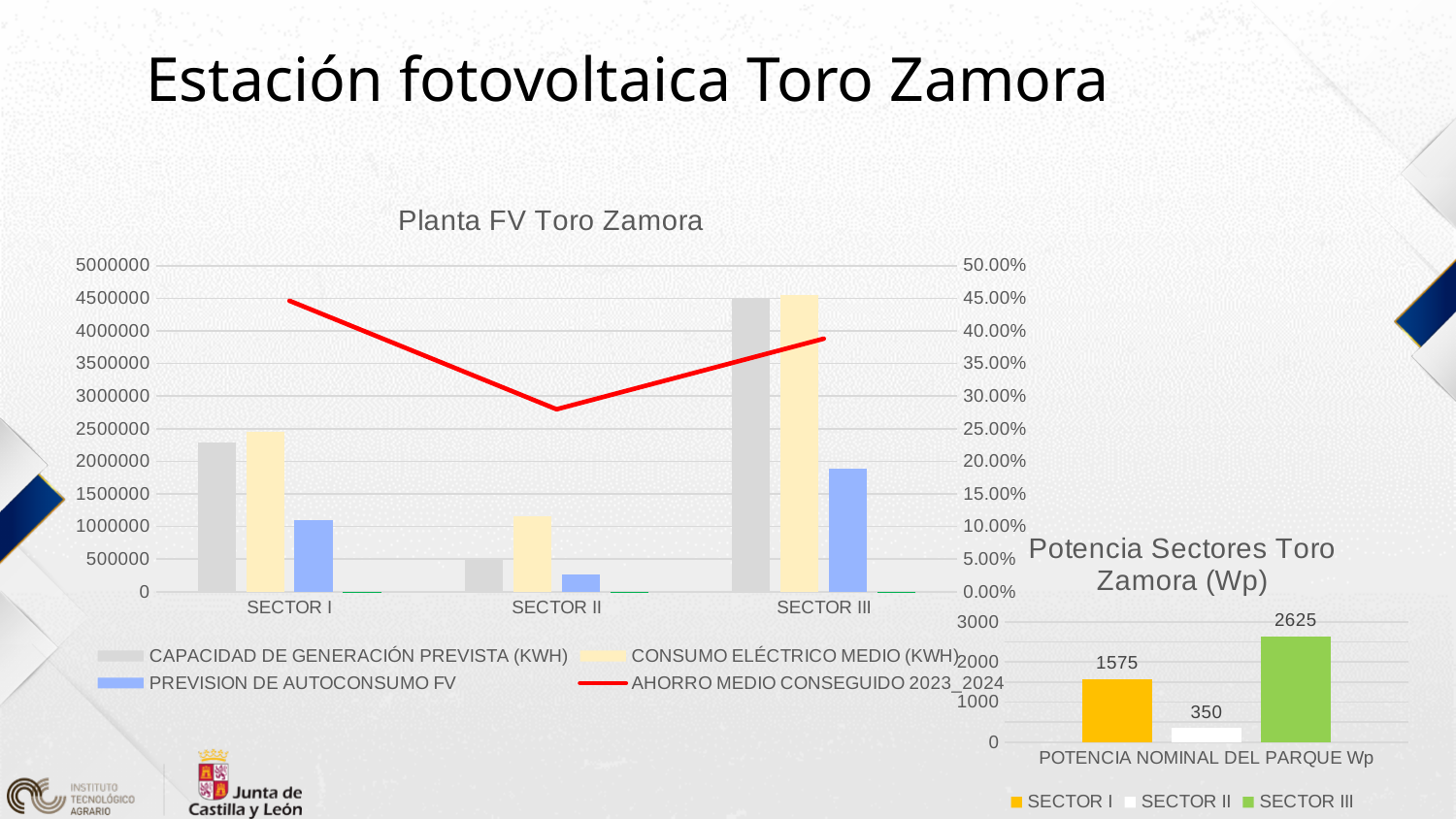
In the 'Potencia Sectores Toro Zamora (Wp)' chart, which sector has the highest value? SECTOR III In the 'Potencia Sectores Toro Zamora (Wp)' chart, which sector has the lowest value? SECTOR II In the 'Potencia Sectores Toro Zamora (Wp)' chart, what is the value for SECTOR I? 1575 In the 'Potencia Sectores Toro Zamora (Wp)' chart, what is the difference between SECTOR III and SECTOR I? 1050 In the 'Planta FV Toro Zamora' chart, how many sector categories are shown on the x axis? 3 In the 'Potencia Sectores Toro Zamora (Wp)' chart, what is the sum of the three sector values? 4550 In the 'Planta FV Toro Zamora' chart, is the CONSUMO ELÉCTRICO MEDIO (KWH) value for SECTOR III greater or less than 4000000? greater In the 'Planta FV Toro Zamora' chart, in which sector is CAPACIDAD DE GENERACIÓN PREVISTA (KWH) highest? SECTOR III In the 'Planta FV Toro Zamora' chart, which series is drawn as a red line? AHORRO MEDIO CONSEGUIDO 2023_2024 In the 'Planta FV Toro Zamora' chart, is the AHORRO MEDIO CONSEGUIDO 2023_2024 value for SECTOR II greater or less than 30.00%? less In the 'Potencia Sectores Toro Zamora (Wp)' chart, what is the value for SECTOR II? 350 In the 'Planta FV Toro Zamora' chart, how many series does the legend list? 4